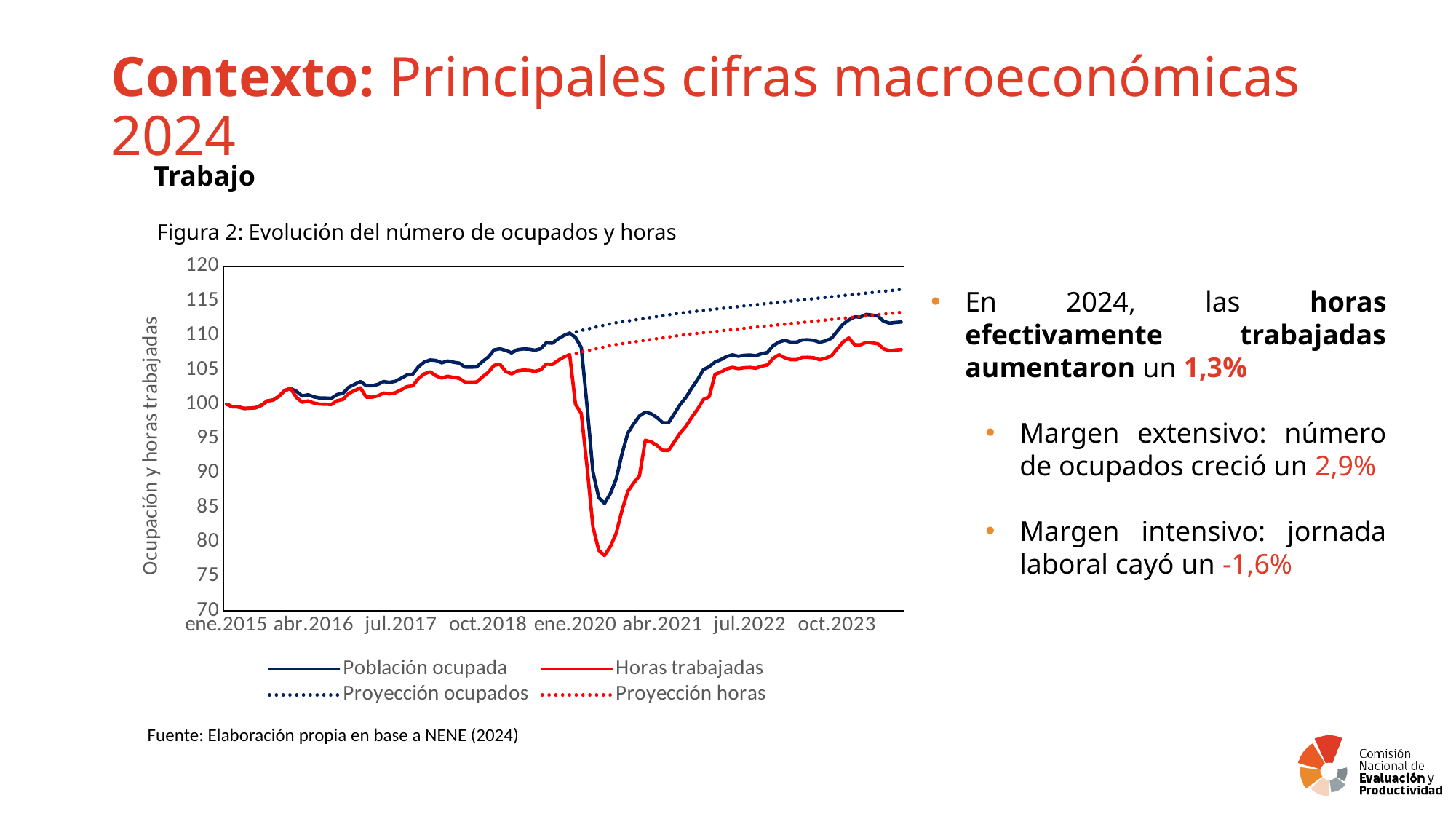
What is the title of the chart on the slide? Figura 2: Evolución del número de ocupados y horas In Figura 2, is the value of Proyección ocupados at the right end of the chart greater or less than 115? greater In Figura 2, does the Proyección horas line rise or fall along the x axis? rise In Figura 2, is the lowest value of Población ocupada greater or less than 90? less In Figura 2, at the right end of the chart, which is higher, Proyección ocupados or Población ocupada? Proyección ocupados In Figura 2, what colour is the Horas trabajadas line? red In Figura 2, is the value of Horas trabajadas at the right end of the chart greater or less than 110? less In Figura 2, at the right end of the chart, which is higher, Población ocupada or Horas trabajadas? Población ocupada What kind of chart is Figura 2? line chart In Figura 2, which series drops to a lower point around 2020, Población ocupada or Horas trabajadas? Horas trabajadas How many series does the legend of Figura 2 list? 4